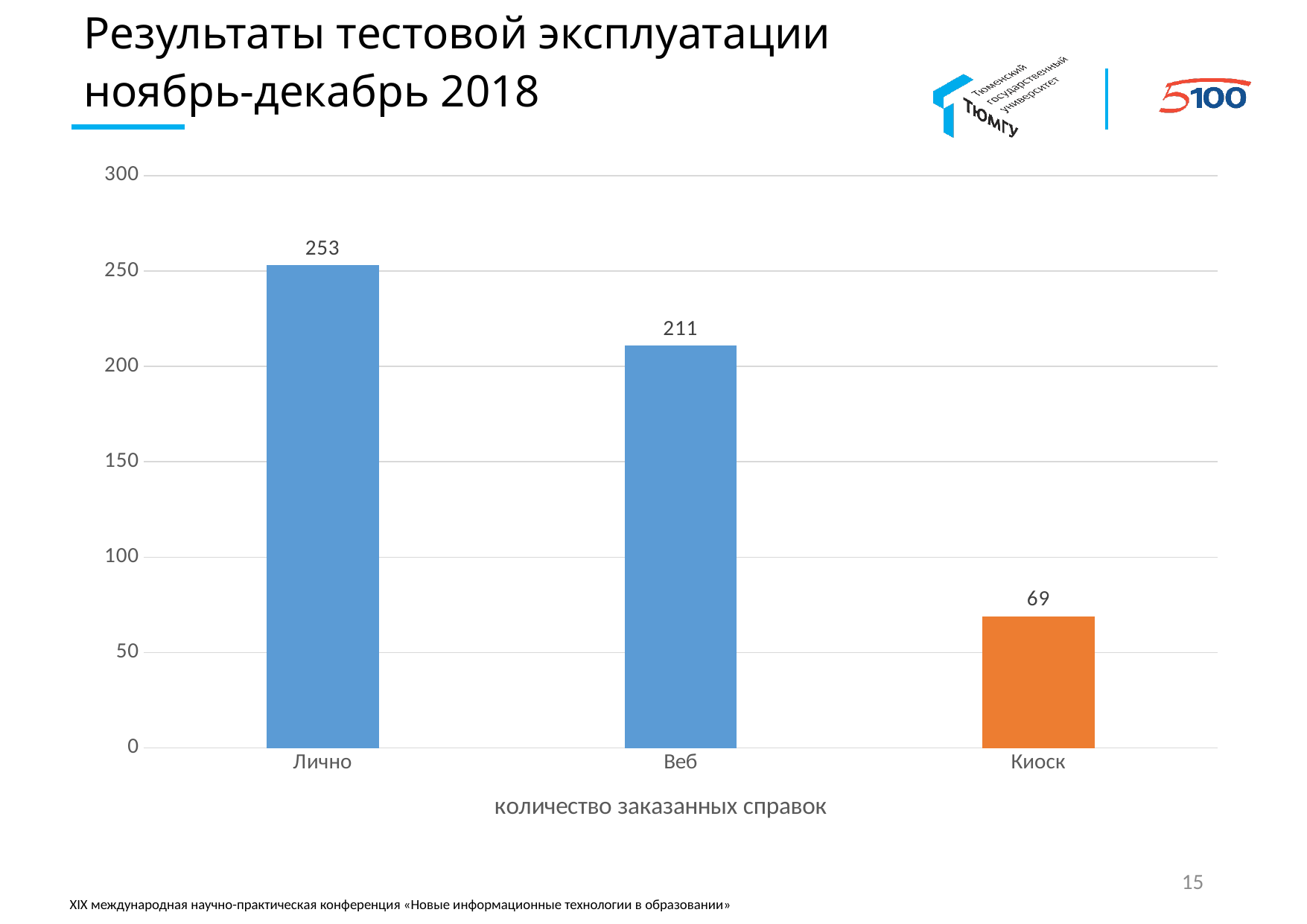
Which is larger, the value for Веб or the value for Киоск? Веб What kind of chart is shown on the slide? bar chart What is the value for Лично? 253 What is the label shown below the x axis of the chart? количество заказанных справок Which category has the highest value? Лично What is the difference between the values for Лично and Веб? 42 How many categories are shown on the x axis? 3 What is the value for Веб? 211 Which category has the lowest value? Киоск What is the value for Киоск? 69 What is the difference between the values for Веб and Киоск? 142 Is the value for Киоск greater or less than 100? less